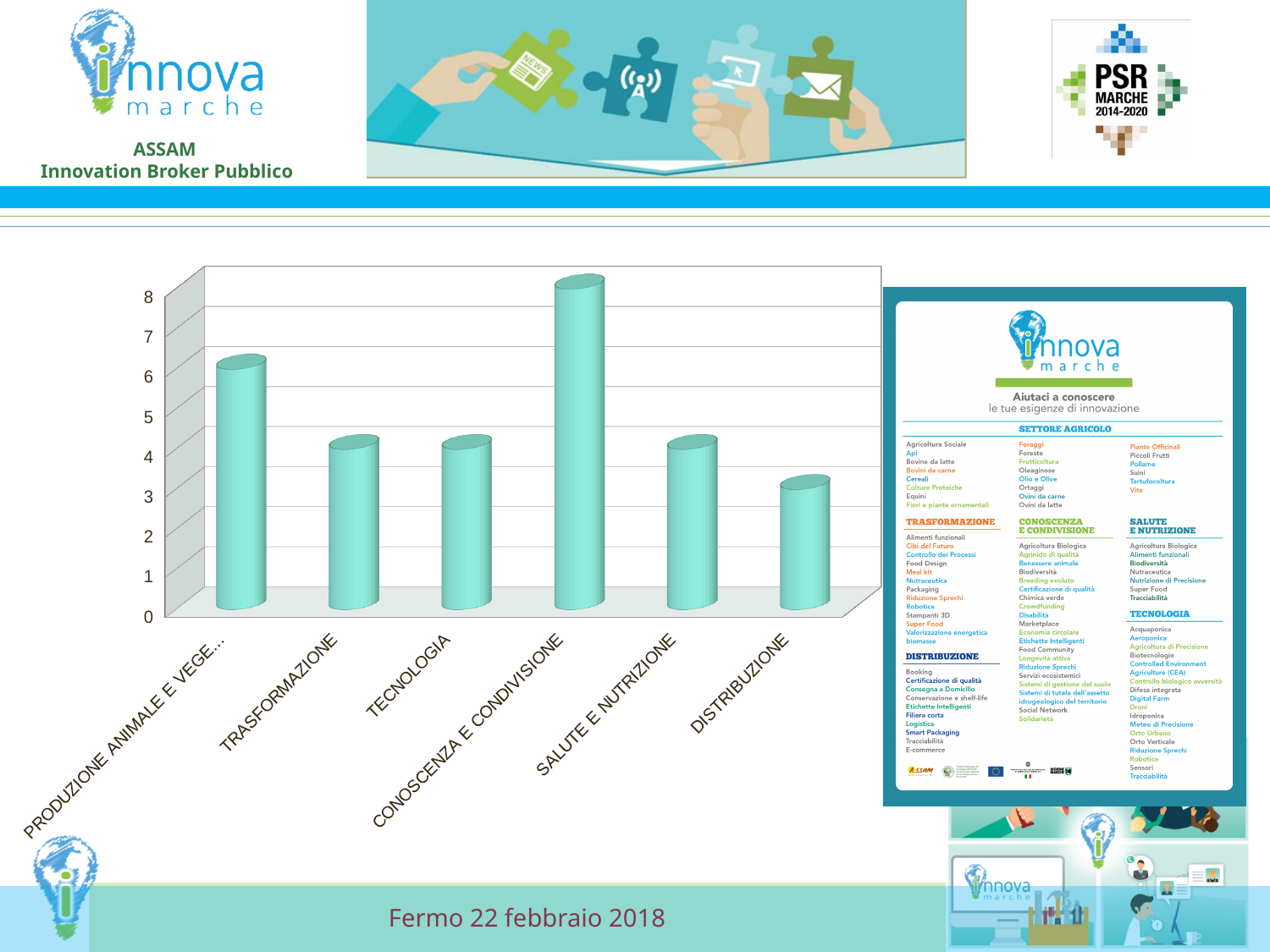
Which category has the lowest bar in the chart? DISTRIBUZIONE Is the value for CONOSCENZA E CONDIVISIONE greater or less than 6? greater How many categories are shown on the x axis of the chart? 6 Is the value for PRODUZIONE ANIMALE E VEGE... greater or less than 5? greater Which is larger, the value for PRODUZIONE ANIMALE E VEGE... or the value for TECNOLOGIA? PRODUZIONE ANIMALE E VEGE... Which is larger, the value for CONOSCENZA E CONDIVISIONE or the value for DISTRIBUZIONE? CONOSCENZA E CONDIVISIONE Is the value for DISTRIBUZIONE greater or less than 4? less Which category has the highest bar in the chart? CONOSCENZA E CONDIVISIONE What is the highest tick value shown on the vertical axis of the chart? 8 What kind of chart is shown on the slide? bar chart